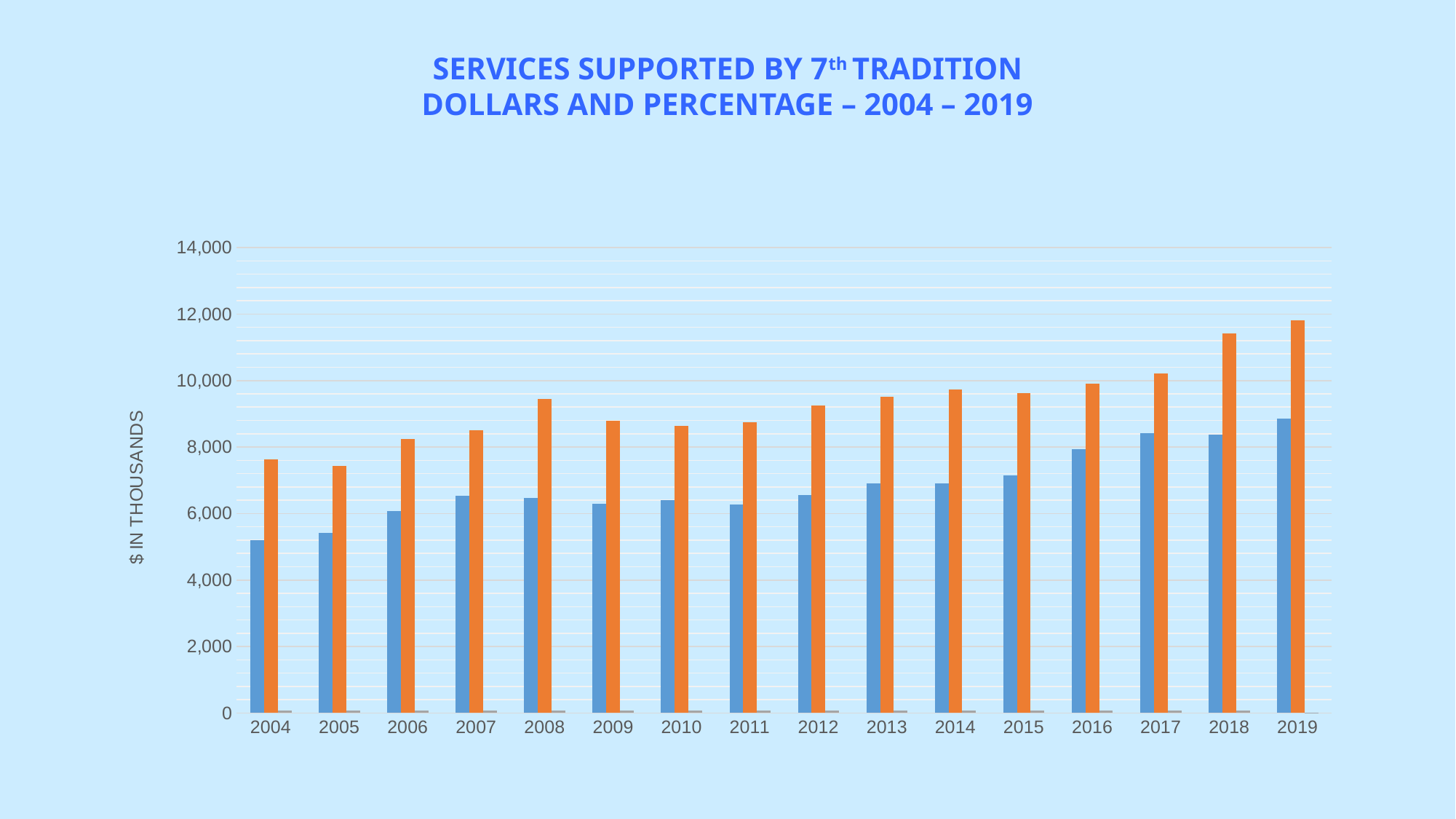
Is the value of the orange bar for 2019 greater or less than 10,000? greater What is the label on the vertical axis of the chart? $ IN THOUSANDS How many years are shown along the x axis of the chart? 16 In 2010, which bar is taller, the blue bar or the orange bar? the orange bar Is the value of the orange bar for 2004 greater or less than 8,000? less Is the value of the blue bar for 2019 greater or less than 8,000? greater In which year is the blue bar the tallest? 2019 What kind of chart is shown on the slide? bar chart Do the orange bars generally rise or fall from 2009 to 2019? rise What is the title of the chart? Services Supported by 7th Tradition Dollars and Percentage – 2004 – 2019 In which year is the orange bar the tallest? 2019